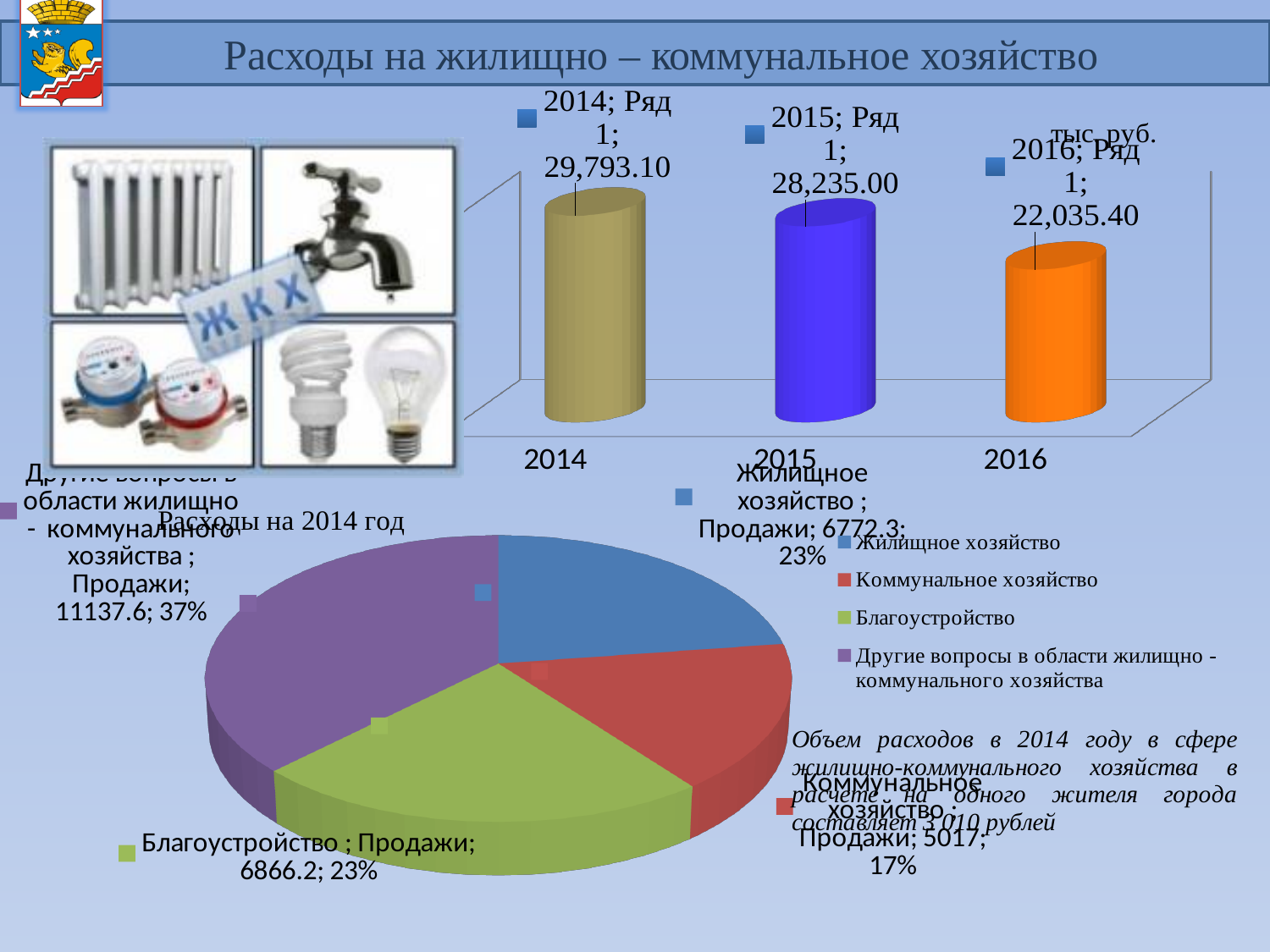
In the pie chart 'Расходы на 2014 год', what is the value for 'Коммунальное хозяйство'? 5017 In the pie chart 'Расходы на 2014 год', what share does 'Другие вопросы в области жилищно - коммунального хозяйства' have? 37% How many categories does the legend of the pie chart 'Расходы на 2014 год' list? 4 How many years are shown in the bar chart at the top of the slide? 3 In the bar chart at the top of the slide, which year has the highest value? 2014 What type of chart is the chart at the top of the slide? bar chart In the pie chart 'Расходы на 2014 год', which category has the smallest slice? Коммунальное хозяйство In the bar chart at the top of the slide, what is the value for 2016? 22,035.40 In the bar chart at the top of the slide, which year has the lowest value? 2016 In the bar chart at the top of the slide, what is the value for 2014? 29,793.10 In the bar chart at the top of the slide, what is the difference between the values for 2015 and 2016? 6,199.60 In the bar chart at the top of the slide, do the values rise or fall from 2014 to 2016? fall